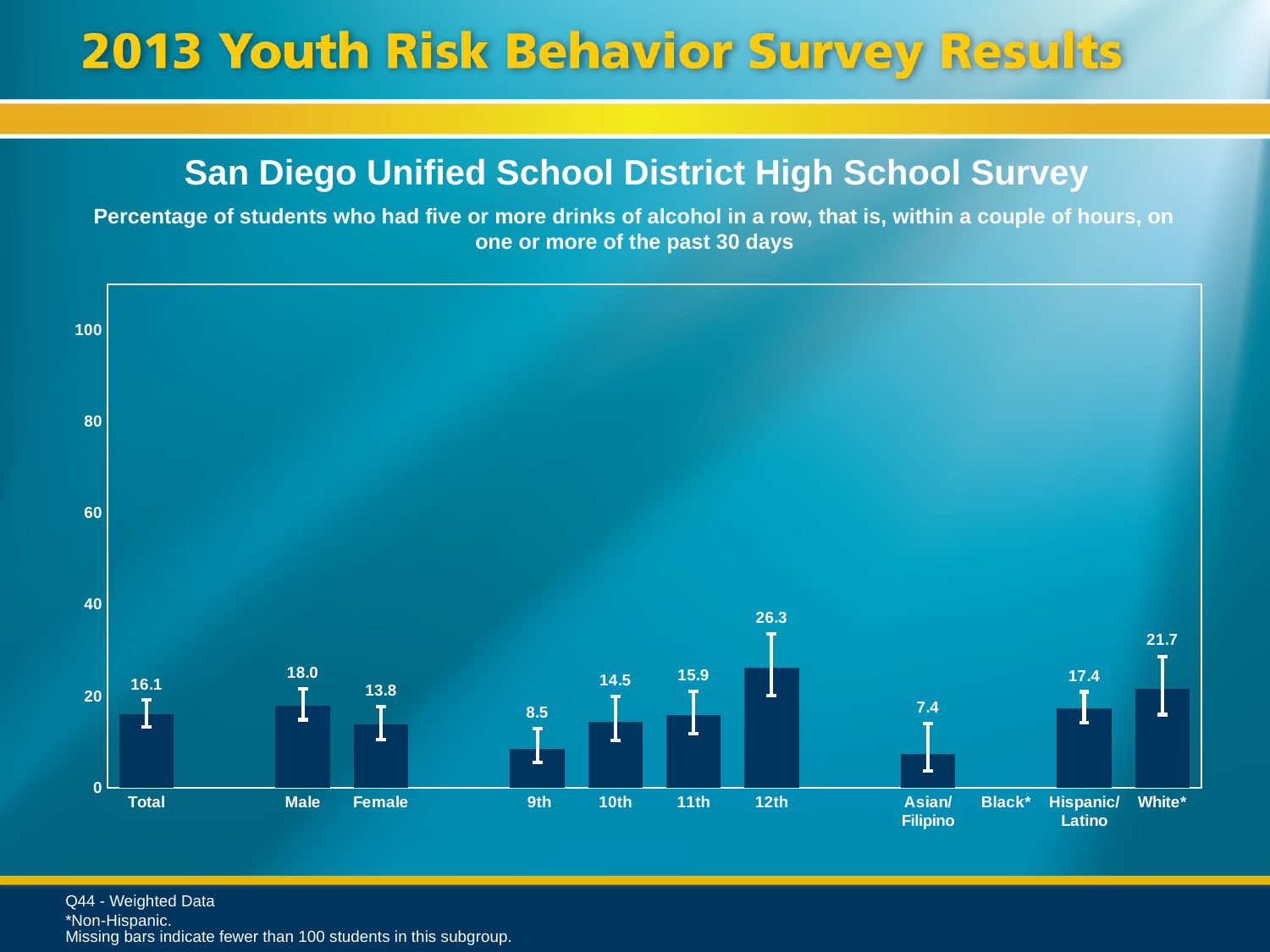
Which is larger, the value for White* or the value for Hispanic/Latino? White* What kind of chart is shown? bar chart What is the value for 12th grade? 26.3 What is the difference between the Male and Female values? 4.2 Which category with a plotted bar has the lowest value? Asian/Filipino Which category has no bar plotted? Black* What is the value for Asian/Filipino? 7.4 Which category has the highest value? 12th Do the values rise or fall from 9th grade to 12th grade? rise What is the value for Total? 16.1 Is the value for 12th grade greater or less than 20? greater How many bars are plotted on the chart? 10